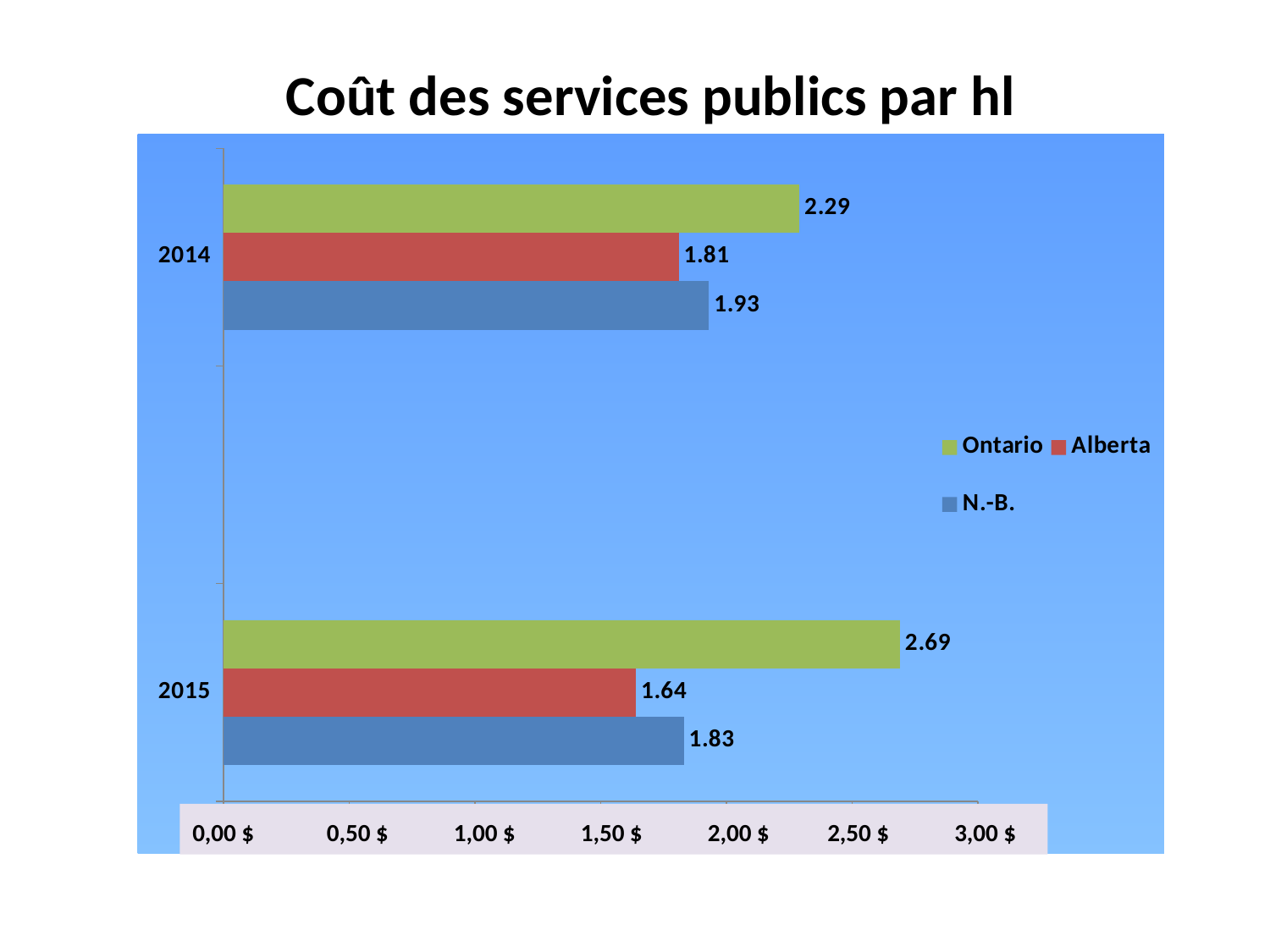
What is the value for Ontario in 2014? 2.29 What is the difference between N.-B. and Alberta in 2015? 0.19 Which is larger, the N.-B. value in 2014 or the N.-B. value in 2015? 2014 How many series does the legend list? 3 Which series has the highest value in 2015? Ontario What is the title of the chart? Coût des services publics par hl Is the value for Ontario in 2015 greater or less than 2,50 $? greater Which series has the lowest value in 2014? Alberta What is the difference between the Ontario values for 2015 and 2014? 0.40 What is the value for N.-B. in 2014? 1.93 What is the value for Alberta in 2015? 1.64 What kind of chart is shown on the slide? Bar chart